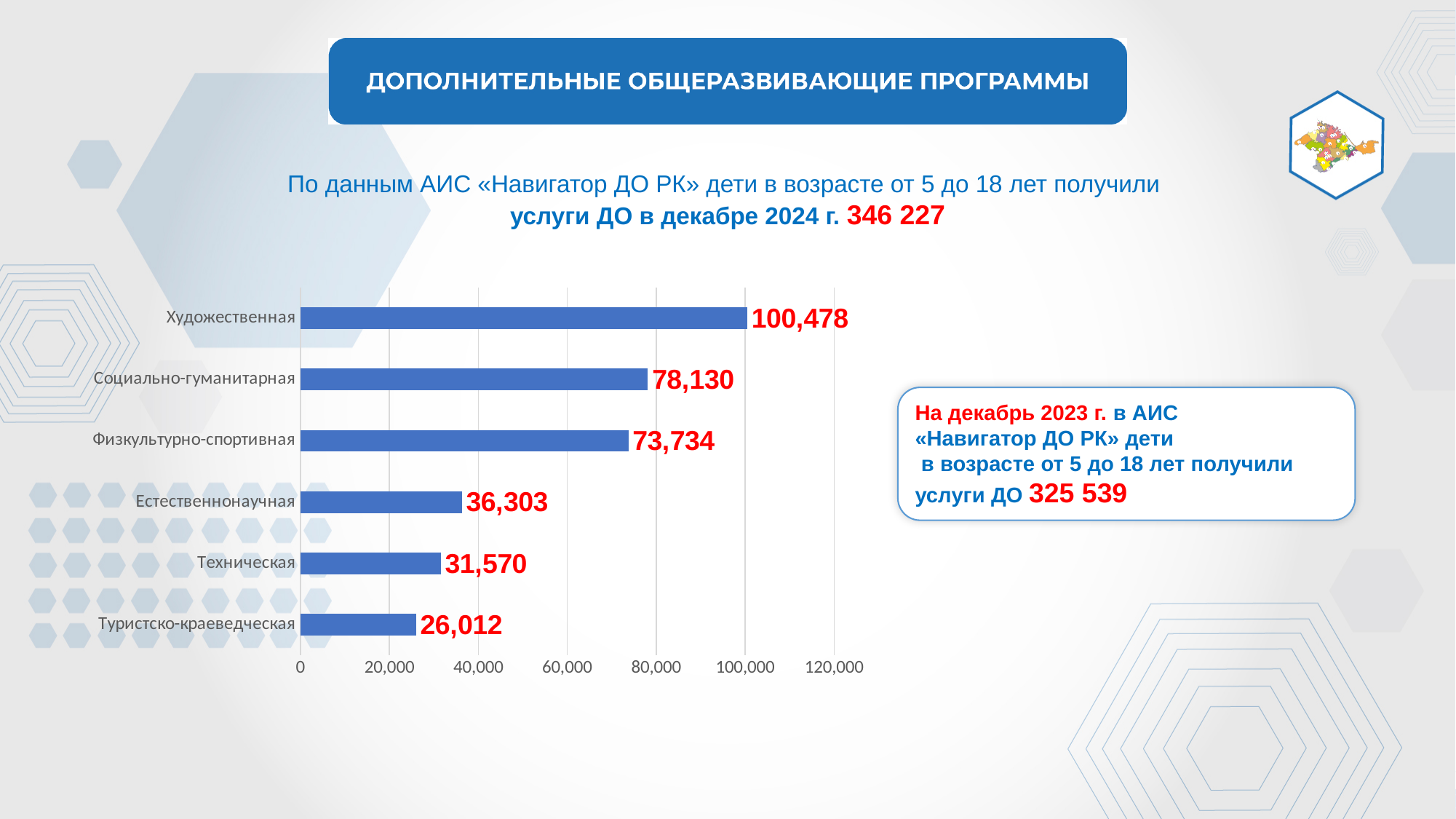
What is the value for Туристско-краеведческая? 26,012 Which category has the lowest value? Туристско-краеведческая Do the values rise or fall going from the top category to the bottom category? fall What is the difference between the values for Художественная and Социально-гуманитарная? 22,348 What is the value for Физкультурно-спортивная? 73,734 Is the value for Техническая greater or less than 40,000? less Which is larger, the value for Социально-гуманитарная or Физкультурно-спортивная? Социально-гуманитарная What type of chart is shown on the slide? Bar chart How many categories are shown in the bar chart? 6 What is the difference between the values for Естественнонаучная and Техническая? 4,733 Which category has the highest value? Художественная What is the value for Художественная? 100,478